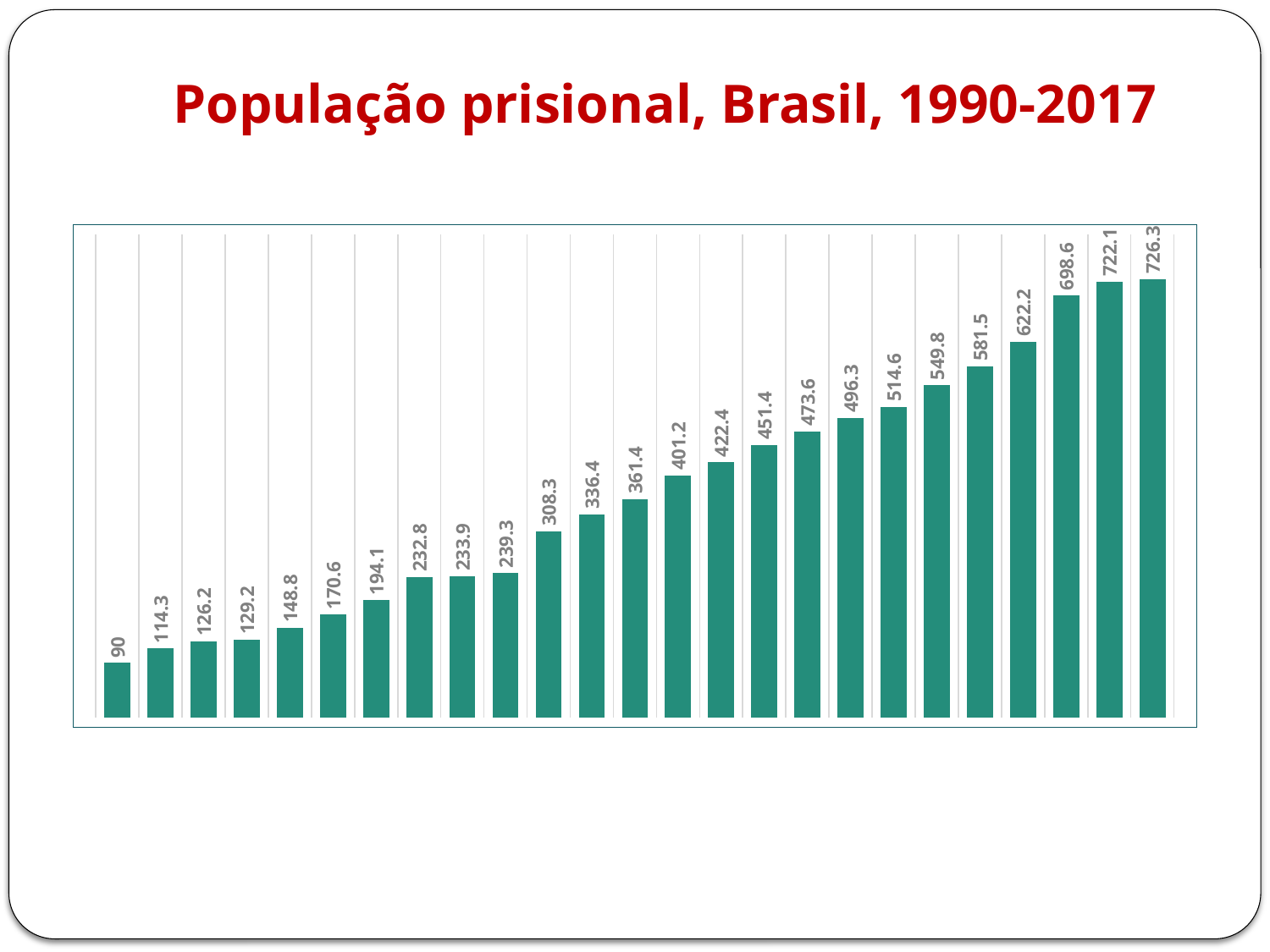
What is the title of the chart? População prisional, Brasil, 1990-2017 What is the difference between the two tallest bars, 726.3 and 722.1? 4.2 What is the highest value shown in the chart? 726.3 Do the values generally rise or fall from left to right across the chart? rise What is the value of the leftmost bar in the chart? 90 How many bars are plotted in the chart? 25 What colour are the bars in the chart? teal green What is the difference between the rightmost bar (726.3) and the leftmost bar (90)? 636.3 What is the value of the rightmost bar in the chart? 726.3 What kind of chart is shown on the slide? bar chart Which is larger, the bar labelled 308.3 or the bar labelled 239.3? 308.3 What is the lowest value shown in the chart? 90